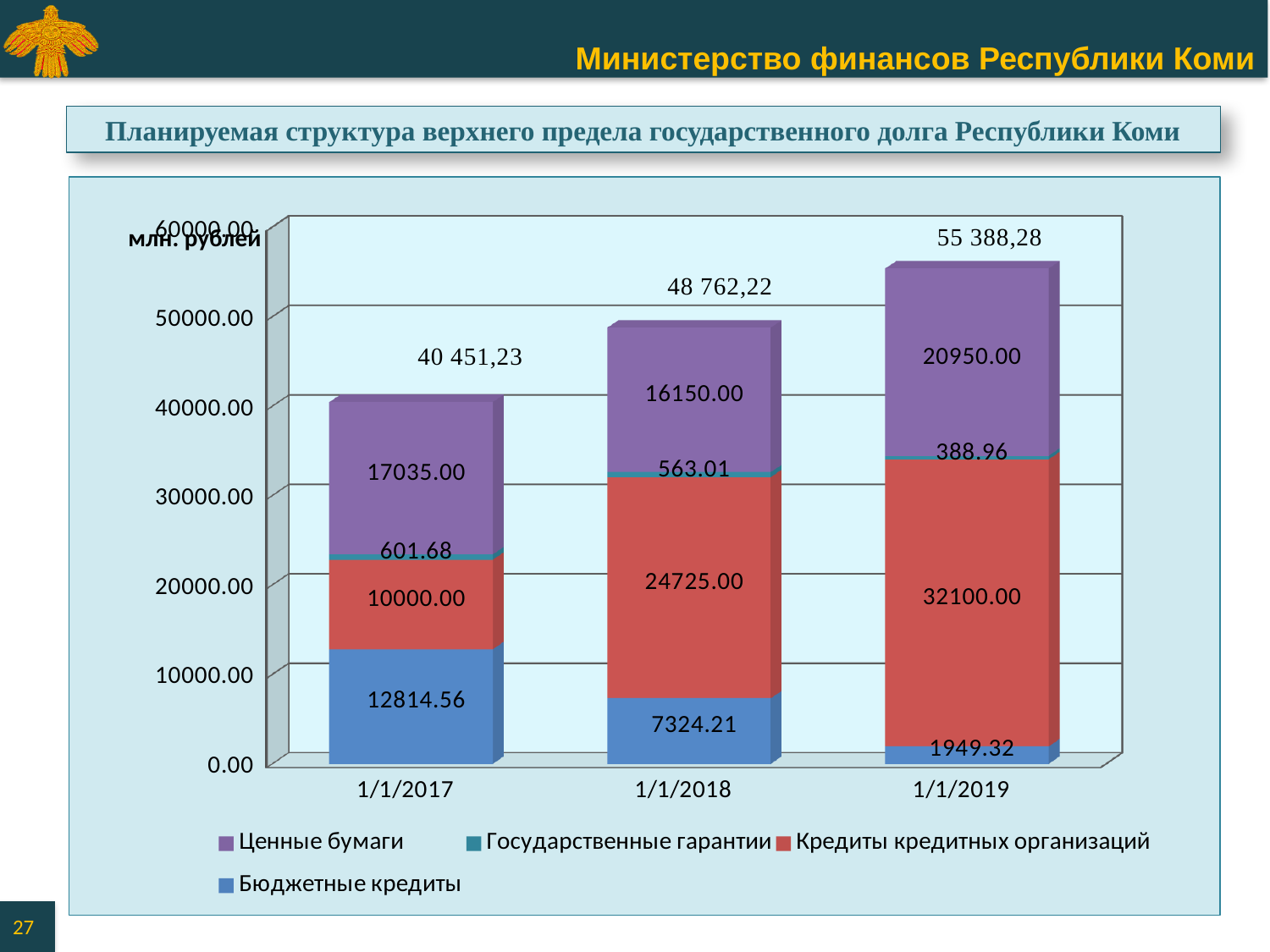
What is the value of Бюджетные кредиты for 1/1/2017? 12814.56 How many dates are shown on the x axis? 3 What is the total of the stacked bar for 1/1/2018? 48 762,22 Which is larger: Кредиты кредитных организаций for 1/1/2017 or Бюджетные кредиты for 1/1/2017? Бюджетные кредиты for 1/1/2017 Which date has the highest total debt? 1/1/2019 What is the value of Государственные гарантии for 1/1/2018? 563.01 Do the total values rise or fall from 1/1/2017 to 1/1/2019? Rise Which date has the lowest value for Бюджетные кредиты? 1/1/2019 What is the value of Кредиты кредитных организаций for 1/1/2019? 32100.00 What kind of chart is shown on the slide? Stacked bar chart What is the difference between Ценные бумаги for 1/1/2019 and for 1/1/2018? 4800.00 How many series does the legend list? 4